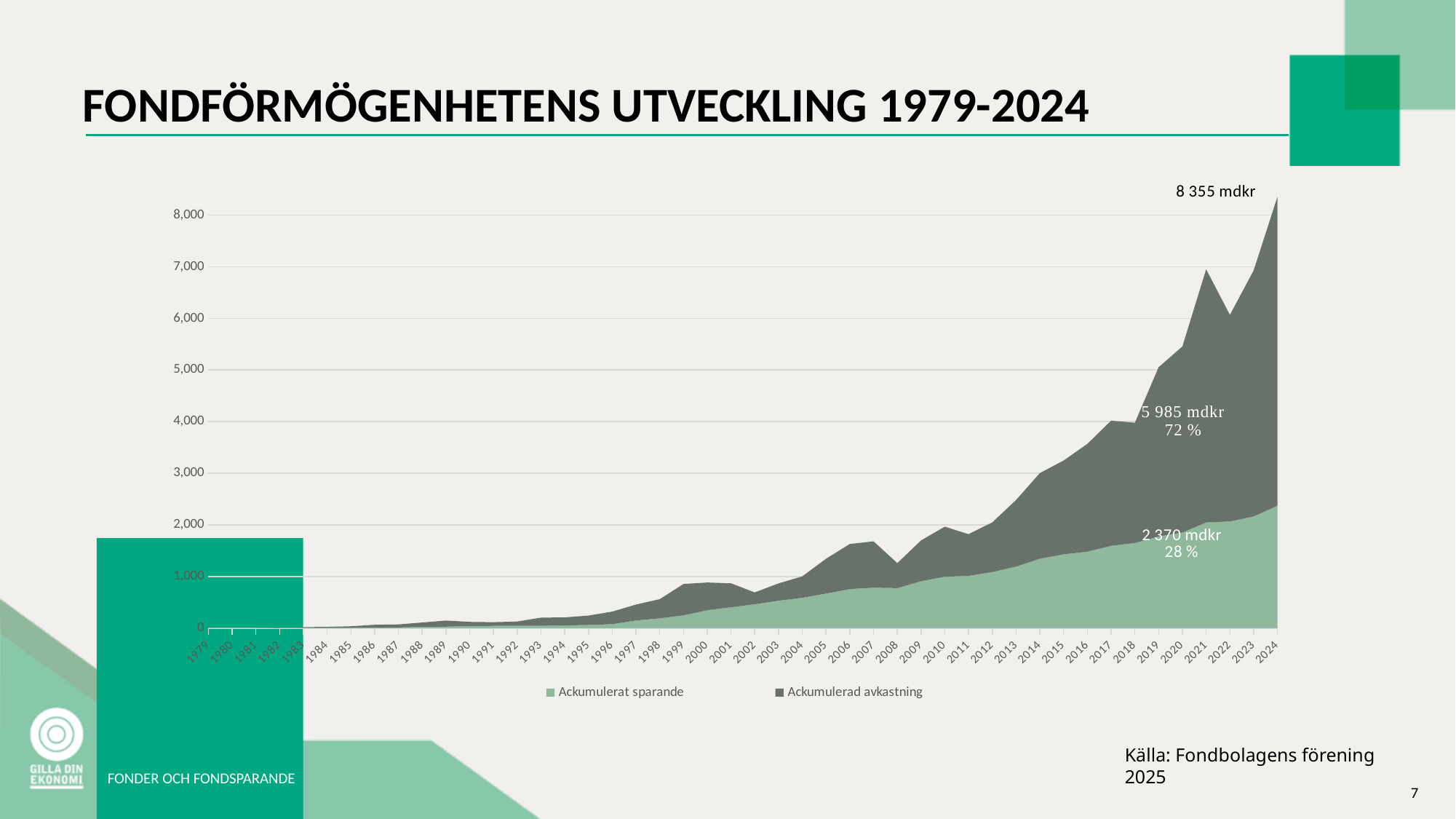
What is the overall trend of the total fund wealth from 1979 to 2024? Rising Is the total value for 2021 greater or less than 6,000? greater What is the value of Ackumulerad avkastning labelled for 2024? 5 985 mdkr How many series does the legend list? 2 What is the value of Ackumulerat sparande labelled for 2024? 2 370 mdkr What is the total fund wealth shown for 2024? 8 355 mdkr In which year is the total fund wealth highest? 2024 What kind of chart is shown on the slide? Stacked area chart In 2024, which is larger: Ackumulerat sparande or Ackumulerad avkastning? Ackumulerad avkastning What is the difference between Ackumulerad avkastning and Ackumulerat sparande in 2024? 3 615 mdkr What share of the 2024 total does Ackumulerad avkastning make up, according to the label? 72 % Is the total value for 2010 greater or less than 3,000? less